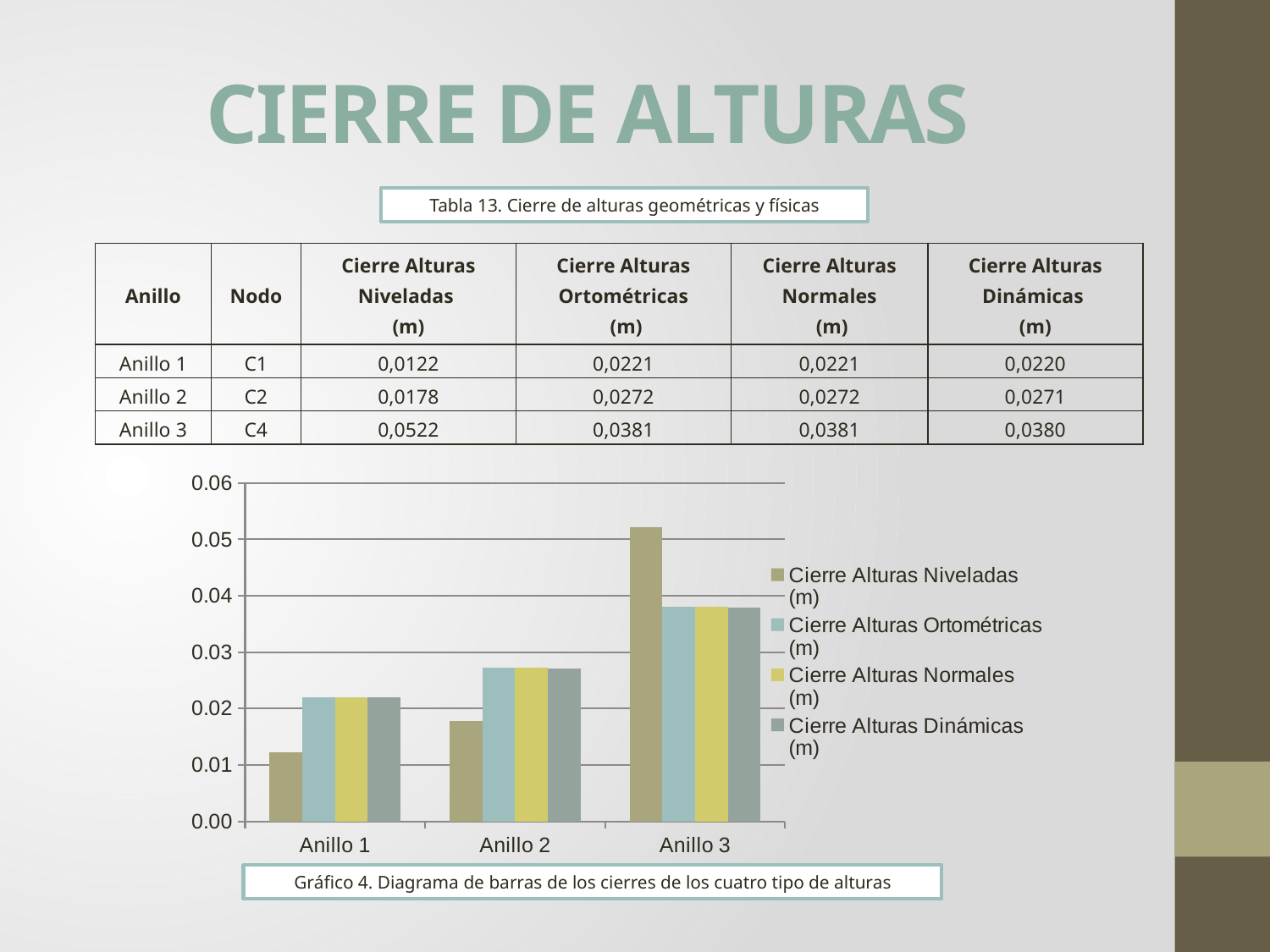
According to the slide, what is the Cierre Alturas Dinámicas (m) value for Anillo 2? 0,0271 Do the Cierre Alturas Ortométricas (m) values rise or fall from Anillo 1 to Anillo 3 in the bar chart? rise How many series does the legend of the bar chart list? 4 In the bar chart, which anillo has the highest value for Cierre Alturas Niveladas (m)? Anillo 3 In the bar chart, is the Cierre Alturas Niveladas (m) value for Anillo 1 greater or less than 0.02? less What kind of chart is shown under the table on the slide? bar chart In the bar chart, is the Cierre Alturas Niveladas (m) value for Anillo 3 greater or less than 0.05? greater How many categories (anillos) are shown along the x axis of the bar chart? 3 What is the caption shown below the bar chart? Gráfico 4. Diagrama de barras de los cierres de los cuatro tipo de alturas For Anillo 2, which is larger in the bar chart: Cierre Alturas Niveladas (m) or Cierre Alturas Ortométricas (m)? Cierre Alturas Ortométricas (m) In the bar chart, which anillo has the lowest value for Cierre Alturas Niveladas (m)? Anillo 1 According to the slide, what is the Cierre Alturas Niveladas (m) value for Anillo 3? 0,0522